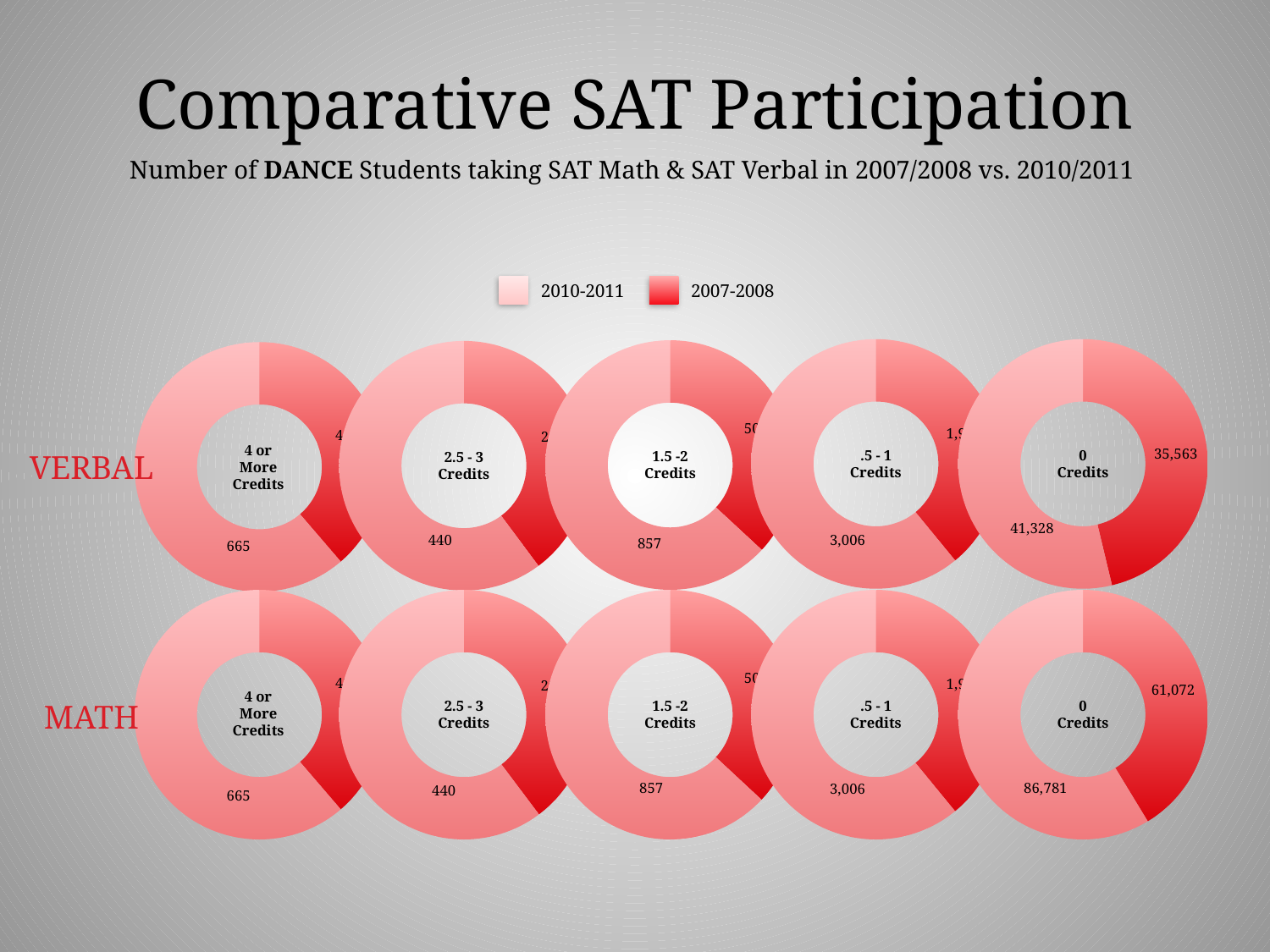
How many series does the legend list? 2 In the VERBAL 0 Credits chart, what is the value for 2007-2008? 35,563 In the VERBAL 0 Credits chart, what is the difference between the 2010-2011 and 2007-2008 values? 5,765 How many doughnut charts are shown on the slide in total? 10 In the VERBAL .5 - 1 Credits chart, what is the value for 2010-2011? 3,006 What kind of chart is used for each of the ten charts on the slide? doughnut chart In the MATH 0 Credits chart, which series has the larger value, 2010-2011 or 2007-2008? 2010-2011 In the MATH 1.5 - 2 Credits chart, what is the value for 2010-2011? 857 In the VERBAL 0 Credits chart, what is the value for 2010-2011? 41,328 In the MATH 0 Credits chart, what is the value for 2010-2011? 86,781 In the MATH 0 Credits chart, what is the value for 2007-2008? 61,072 In the MATH 0 Credits chart, what is the difference between the 2010-2011 and 2007-2008 values? 25,709